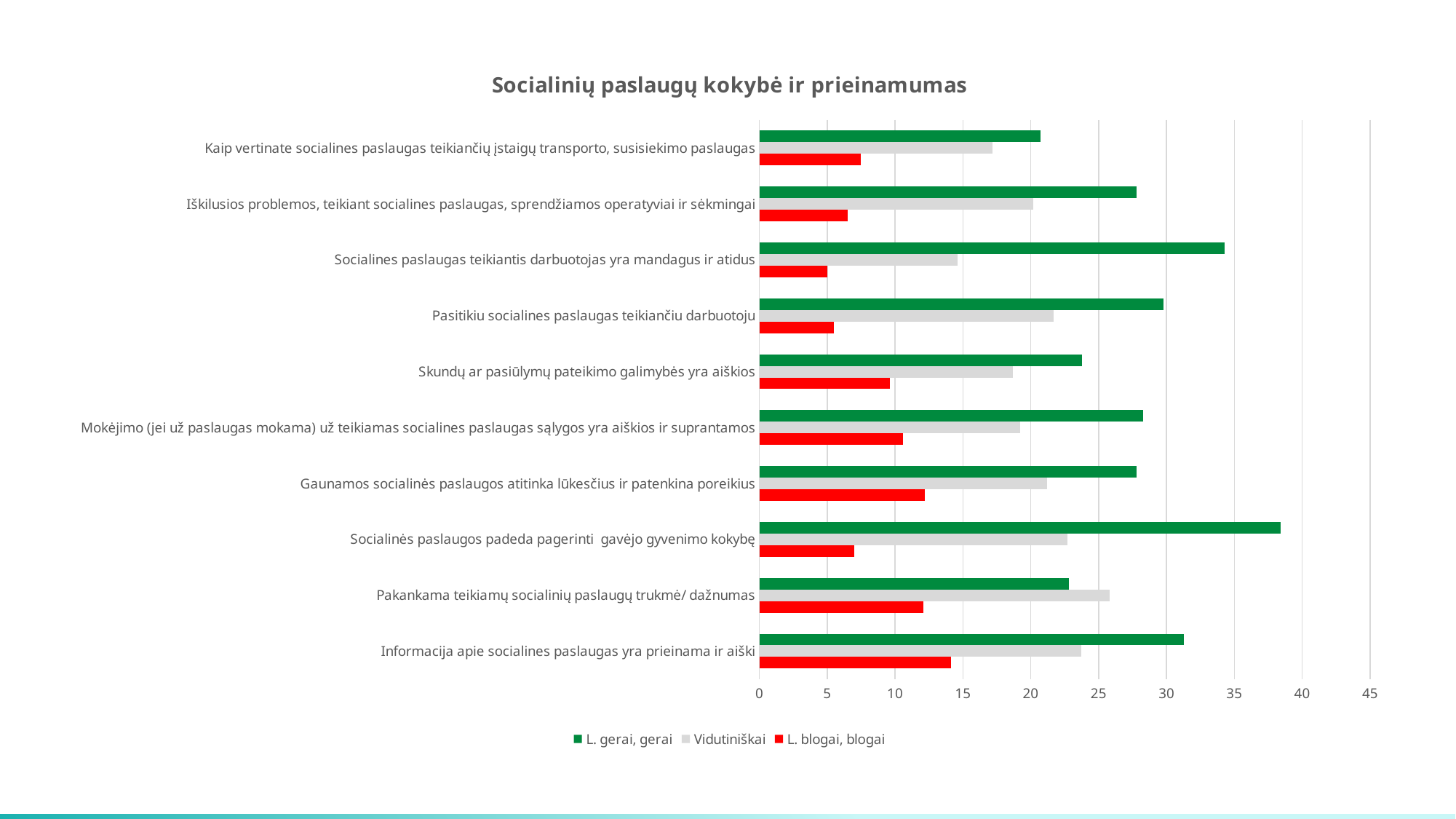
Which category has the highest value for the 'L. gerai, gerai' series? Socialinės paslaugos padeda pagerinti gavėjo gyvenimo kokybę Is the 'L. gerai, gerai' value for 'Socialinės paslaugos padeda pagerinti gavėjo gyvenimo kokybę' greater or less than 35? greater How many categories (statements) are plotted on the chart? 10 Which category has the lowest value for the 'L. gerai, gerai' series? Kaip vertinate socialines paslaugas teikiančių įstaigų transporto, susisiekimo paslaugas Which category has the highest value for the 'Vidutiniškai' series? Pakankama teikiamų socialinių paslaugų trukmė/ dažnumas What kind of chart is shown on the slide? Bar chart What is the title of the chart? Socialinių paslaugų kokybė ir prieinamumas Which category has the highest value for the 'L. blogai, blogai' series? Informacija apie socialines paslaugas yra prieinama ir aiški Which colour represents the 'L. blogai, blogai' series in the chart? Red For 'Pakankama teikiamų socialinių paslaugų trukmė/ dažnumas', which is larger: the 'Vidutiniškai' value or the 'L. gerai, gerai' value? Vidutiniškai How many series does the legend list? 3 Is the 'L. blogai, blogai' value for 'Socialines paslaugas teikiantis darbuotojas yra mandagus ir atidus' greater or less than 10? less